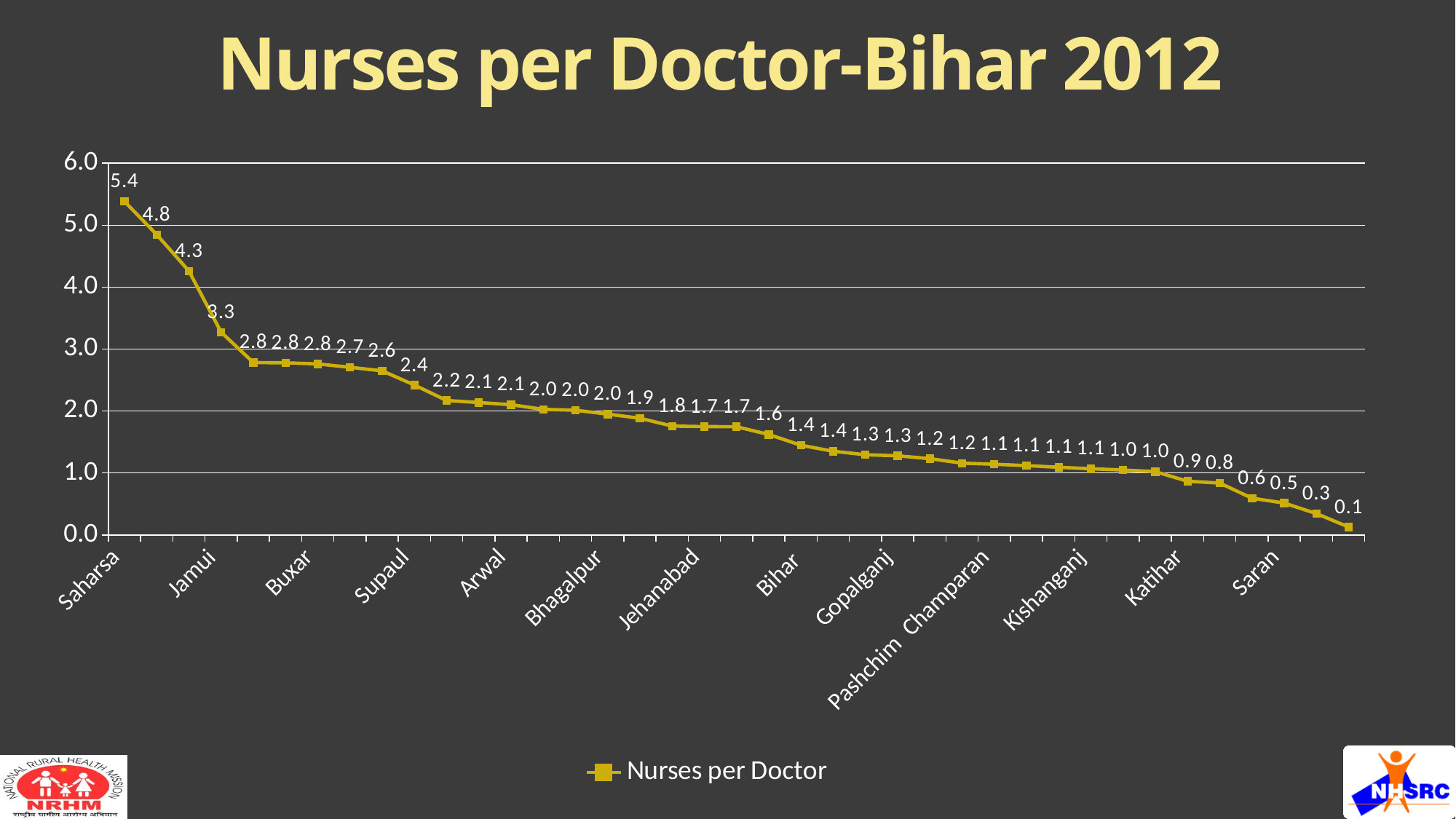
Which district has the highest number of nurses per doctor? Saharsa What is the difference in nurses per doctor between Saharsa and Jamui? 2.1 Which has more nurses per doctor, Buxar or Supaul? Buxar What is the value of nurses per doctor for Katihar? 0.9 How many series does the legend list? 1 Do the values rise or fall from left to right along the x axis? fall What is the value of nurses per doctor for Saran? 0.5 What is the value of nurses per doctor for Saharsa? 5.4 What is the value of nurses per doctor for Bihar? 1.4 Is the value for Jehanabad greater or less than 2.0? less What is the value of nurses per doctor for Jamui? 3.3 What kind of chart is shown on the slide? line chart